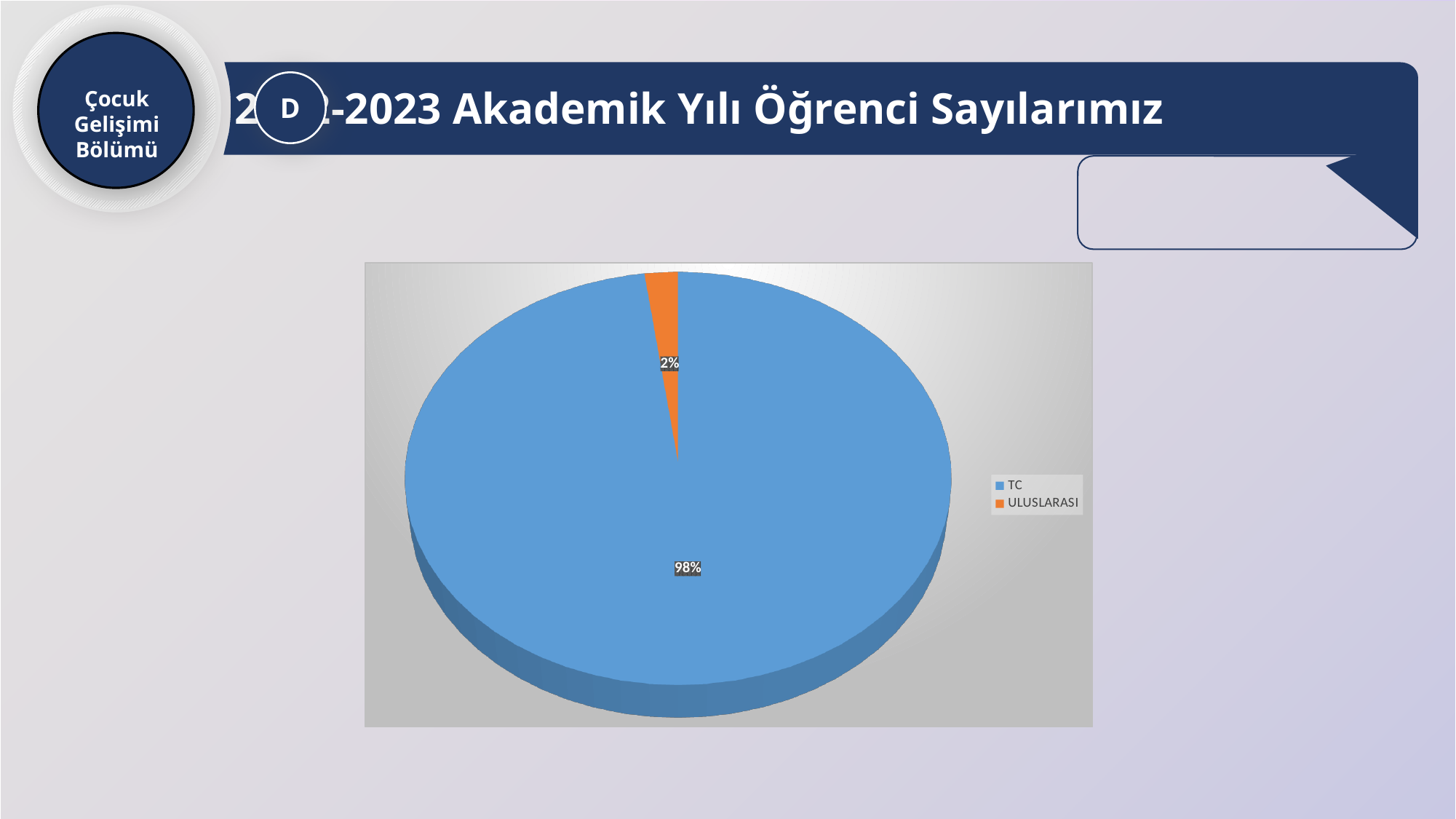
What colour is the slice for TC? blue What kind of chart is shown on the slide? pie chart How many entries does the legend list? 2 Which category has the smallest slice of the pie? ULUSLARASI What share of the pie does ULUSLARASI have? 2% How many categories does the pie chart show? 2 Which is larger, the share for TC or the share for ULUSLARASI? TC What share of the pie does TC have? 98% Which category has the largest slice of the pie? TC What colour is the slice for ULUSLARASI? orange What is the difference in percentage points between the TC share and the ULUSLARASI share? 96%